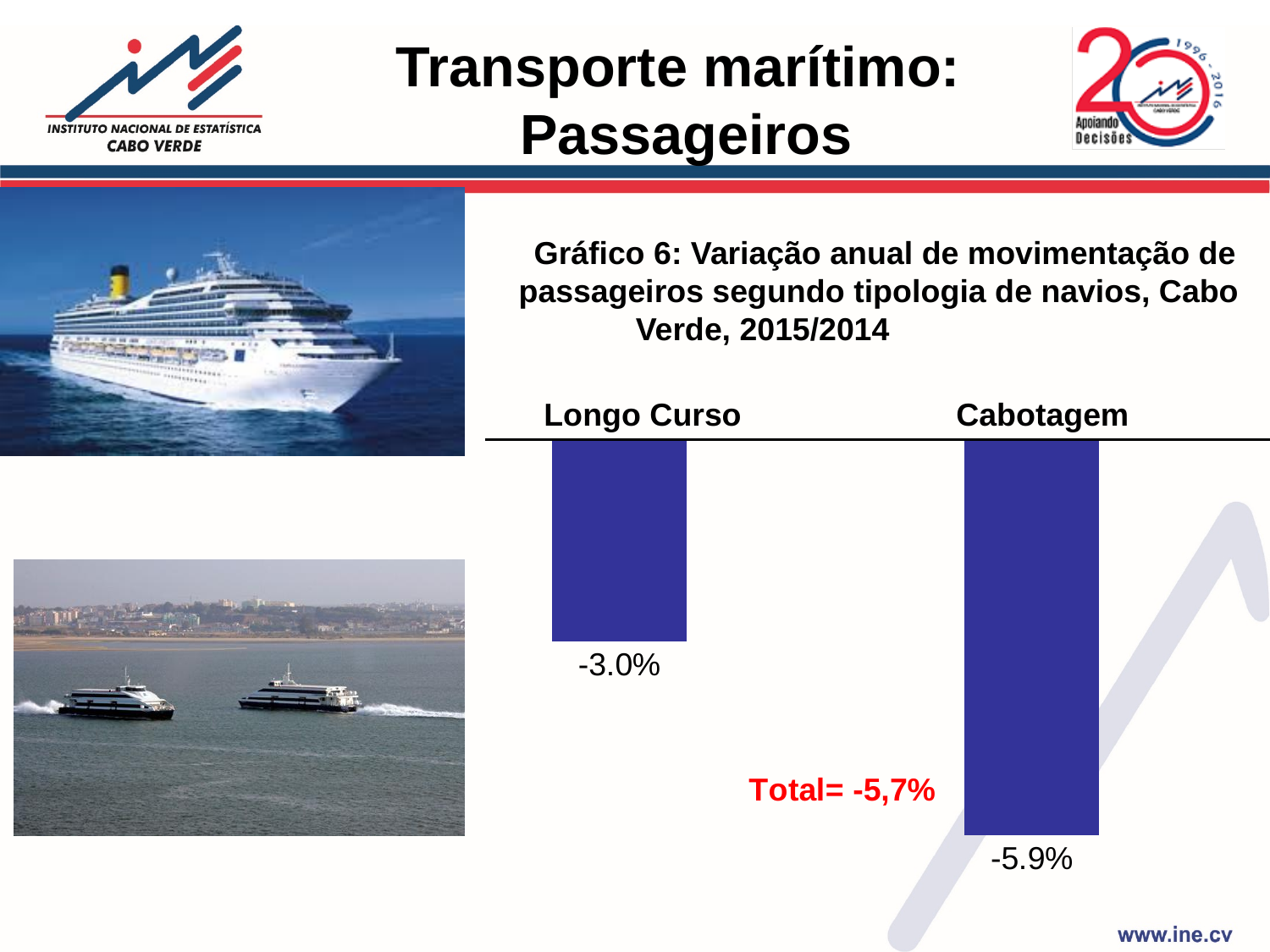
Which category has the lowest value? Cabotagem What is the title of the chart? Gráfico 6: Variação anual de movimentação de passageiros segundo tipologia de navios, Cabo Verde, 2015/2014 How many categories are shown in the chart? 2 What is the value for Longo Curso? -3.0% Which is larger, the value for Longo Curso or the value for Cabotagem? Longo Curso What total value is printed on the chart? -5,7% Which category has the highest value? Longo Curso What is the difference between the values for Longo Curso and Cabotagem? 2.9 percentage points What kind of chart is shown on the slide? Bar chart What is the value for Cabotagem? -5.9%